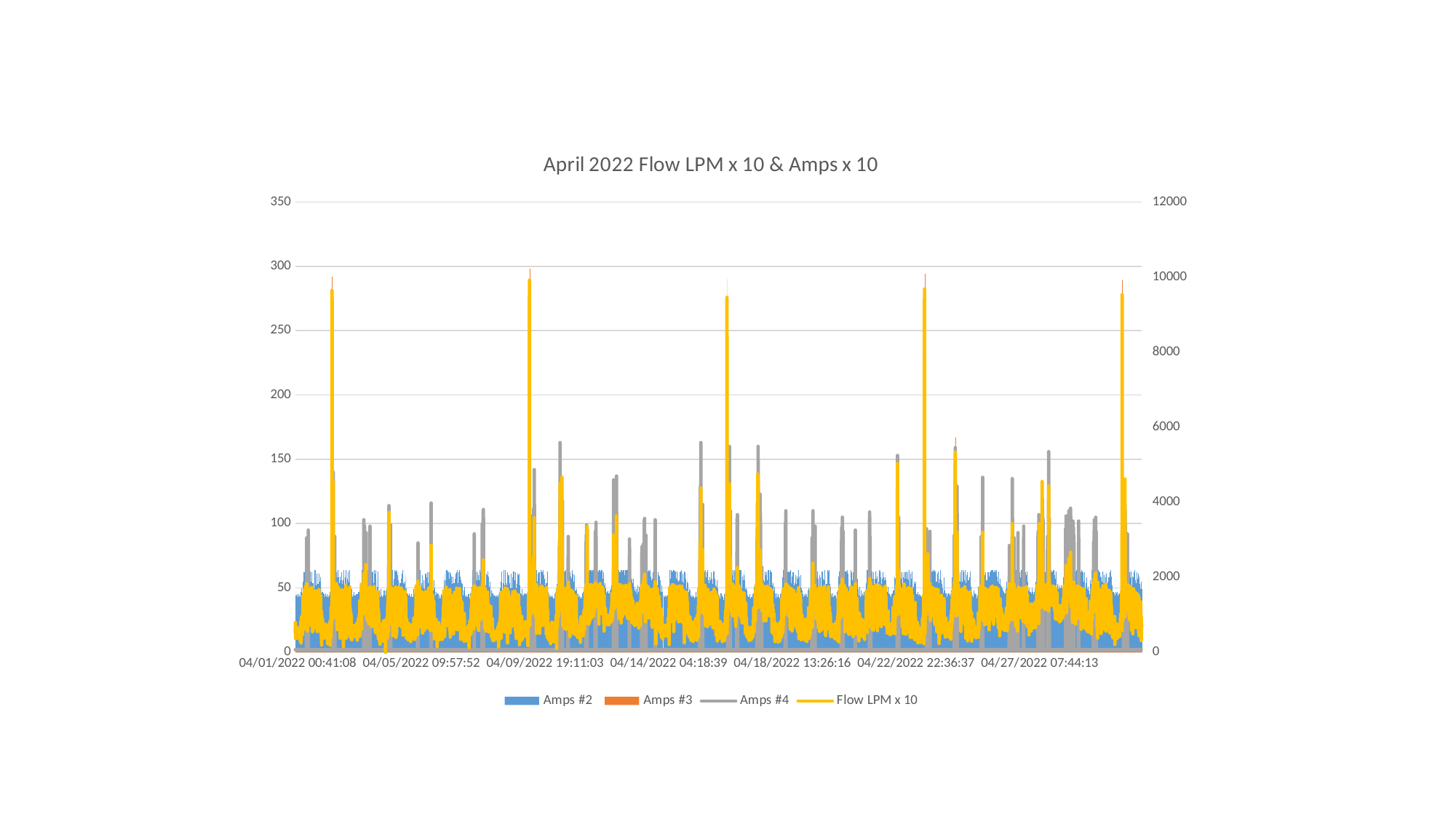
Which series is drawn in yellow? Flow LPM x 10 What is the title of the chart? April 2022 Flow LPM x 10 & Amps x 10 Read against the left-hand axis, is the highest peak of the Amps #2 series greater or less than 100? less How many series does the legend list? 4 Read against the left-hand axis, is the highest peak of the Amps #4 series greater or less than 200? less Read against the right-hand axis, is the highest peak of the Flow LPM x 10 line greater or less than 6000? greater What kind of chart is this? Combination bar and line chart